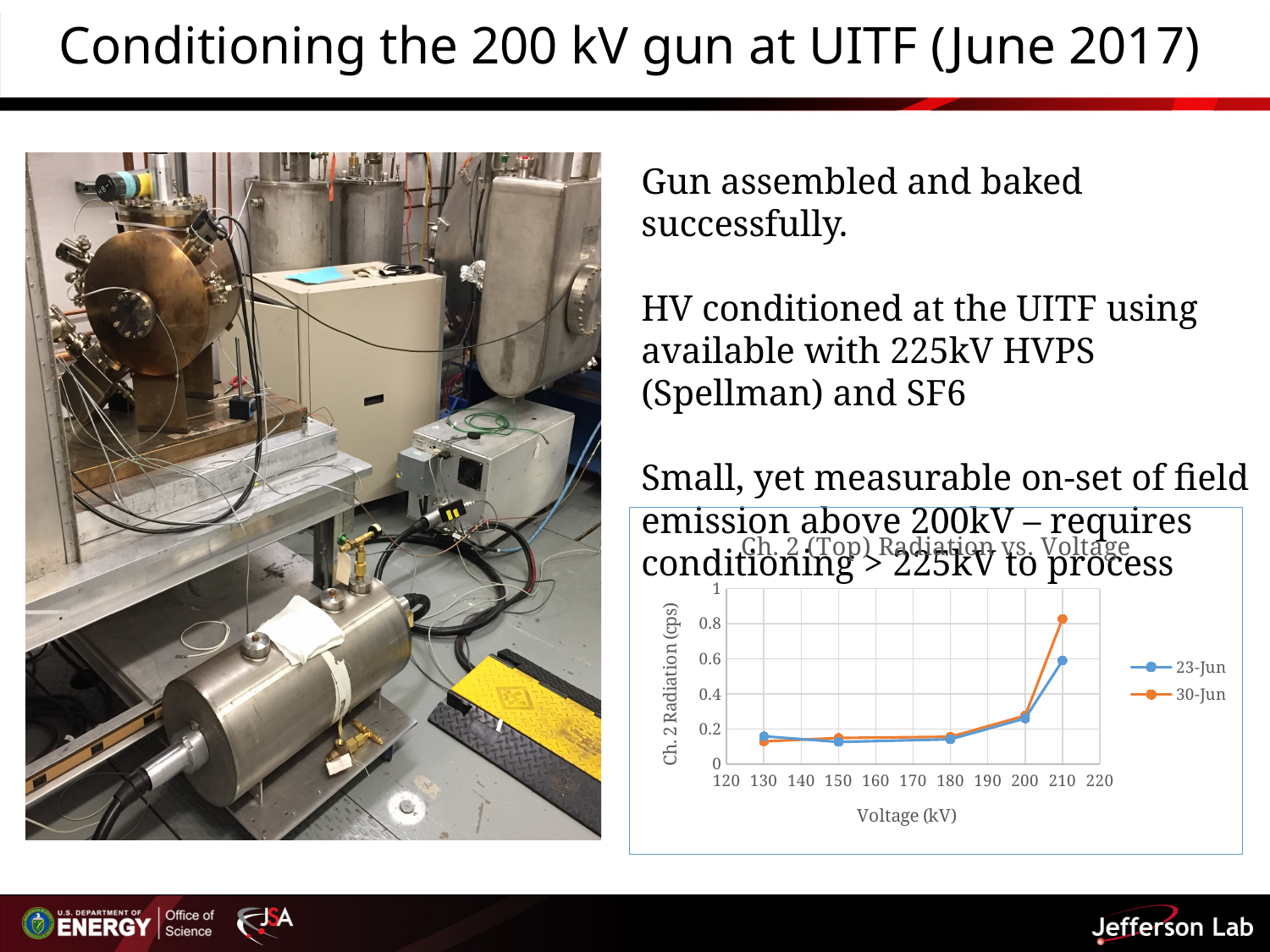
Is the 23-Jun radiation value at 210 kV greater or less than 0.8? less How many data points are plotted for the 30-Jun series? 5 Is the 30-Jun radiation value at 180 kV greater or less than 0.2? less Is the 30-Jun radiation value at 210 kV greater or less than 0.6? greater At which voltage does the 30-Jun series reach its highest radiation value? 210 What are the two series named in the chart legend? 23-Jun and 30-Jun Do the radiation values rise or fall as voltage increases from 180 kV to 210 kV? rise What kind of chart is shown on the slide? line chart What is the title of the chart? Ch. 2 (Top) Radiation vs. Voltage At 210 kV, which series shows the higher radiation, 23-Jun or 30-Jun? 30-Jun How many series does the legend of the chart list? 2